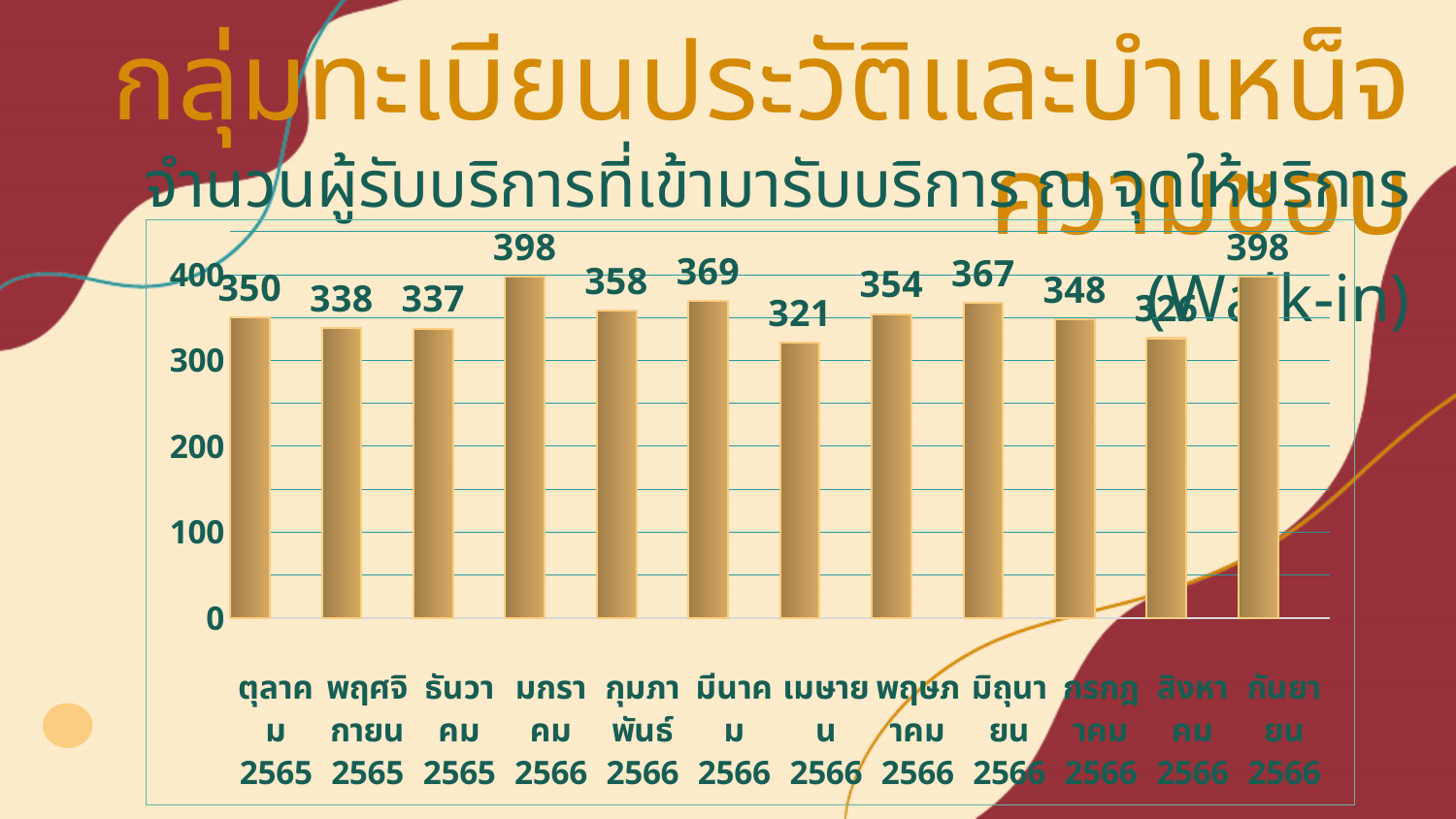
What is the difference between the values for มีนาคม 2566 and เมษายน 2566? 48 Which is larger, the value for พฤษภาคม 2566 or the value for กรกฎาคม 2566? พฤษภาคม 2566 What is the value for มกราคม 2566? 398 What is the difference between the values for มกราคม 2566 and ธันวาคม 2565? 61 What kind of chart is shown on the slide? bar chart Is the value for กุมภาพันธ์ 2566 greater or less than 300? greater How many months are shown on the x axis of the chart? 12 Do the values rise or fall from ตุลาคม 2565 to ธันวาคม 2565? fall What is the value for ตุลาคม 2565? 350 What is the value for เมษายน 2566? 321 What is the value for กันยายน 2566? 398 What is the value for มิถุนายน 2566? 367